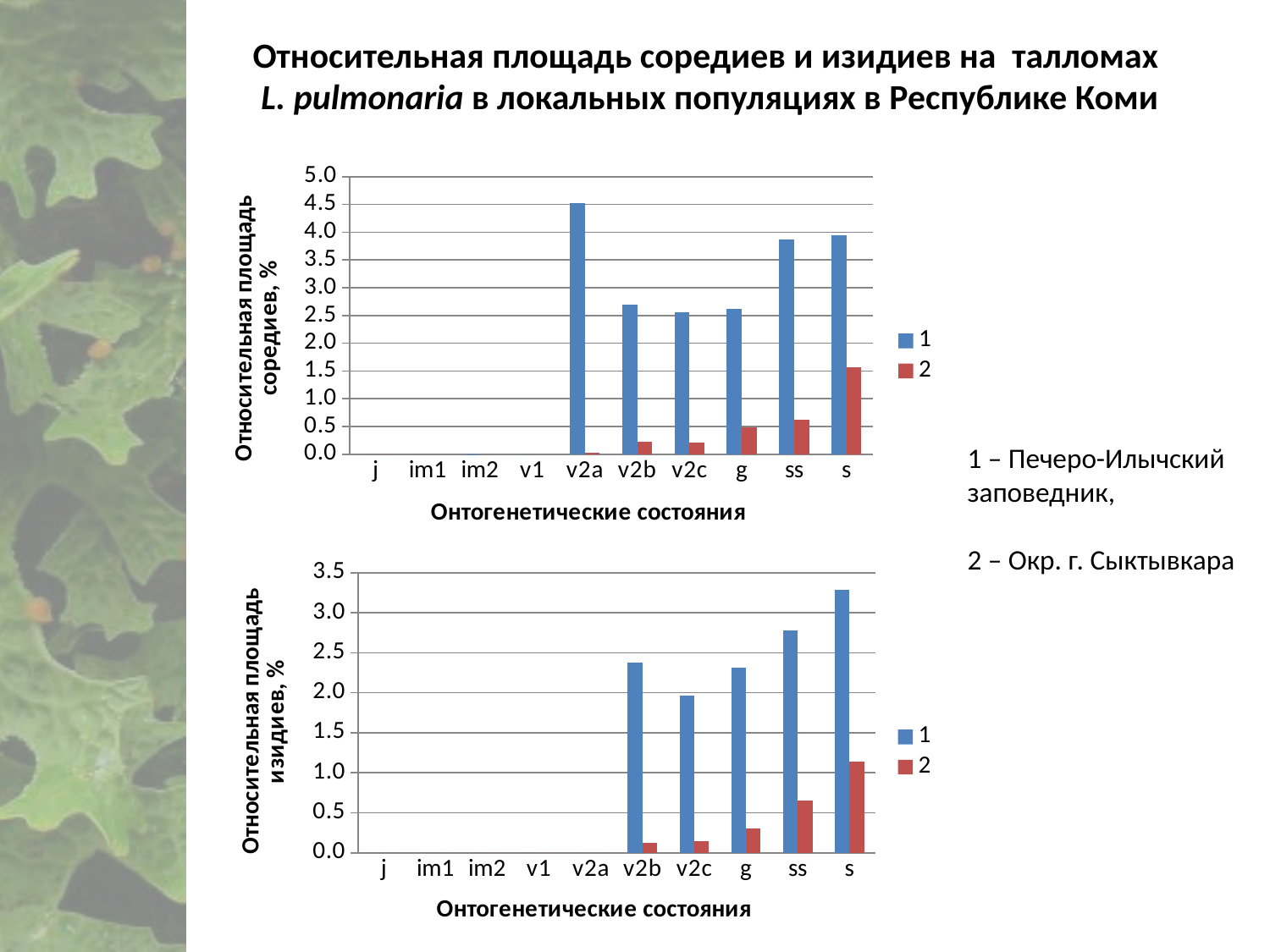
How many categories are shown on the x axis of the bottom chart? 10 In the bottom chart (изидии), which category has the highest value for series 1? s In the bottom chart, which is larger for series 1: the value for ss or the value for v2c? ss In the top chart, which is larger for series 1: the value for v2a or the value for ss? v2a In the bottom chart, is the value of series 1 for s greater or less than 3.0? greater In the top chart, is the value of series 1 for v2a greater or less than 4.0? greater In the top chart (соредии), which category has the highest value for series 1? v2a What kind of chart is the top chart on the slide? bar chart In the top chart, which category has the highest value for series 2? s In the bottom chart, is the value of series 2 for ss greater or less than 1.0? less What is the x-axis title of the bottom chart? Онтогенетические состояния How many series does the legend of the top chart list? 2